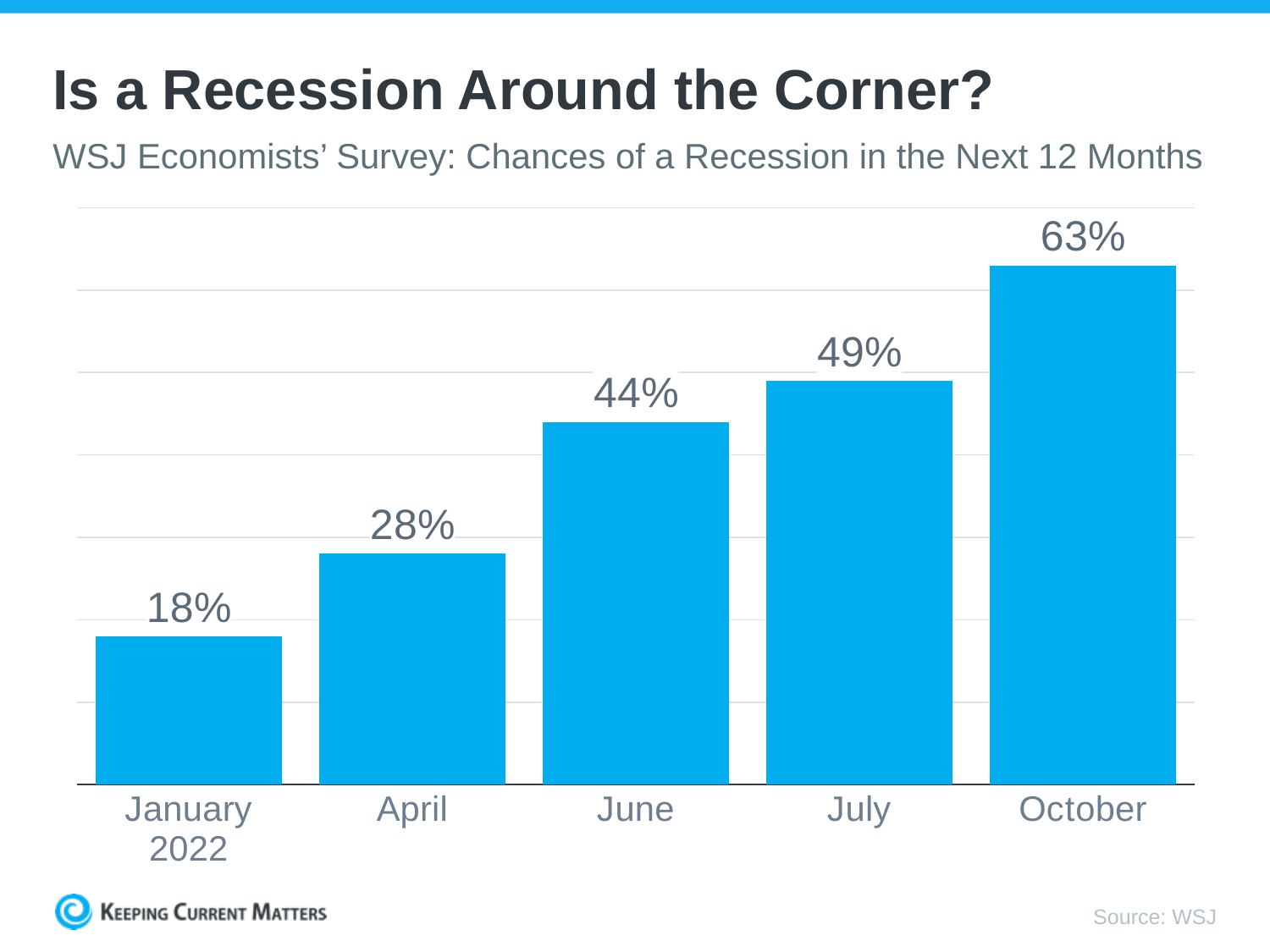
What kind of chart is shown on the slide? Bar chart What value is shown for October? 63% Which is larger, the value for April or the value for June? June Which month has the lowest chance of a recession? January 2022 What is the difference between the July value and the June value? 5% How many months are shown on the chart? 5 What value is shown for June? 44% What is the difference between the October value and the January 2022 value? 45% What is the chance of a recession shown for January 2022? 18% Do the values rise or fall from January 2022 to October? Rise Which month has the highest chance of a recession? October What is the subtitle of the chart? WSJ Economists' Survey: Chances of a Recession in the Next 12 Months